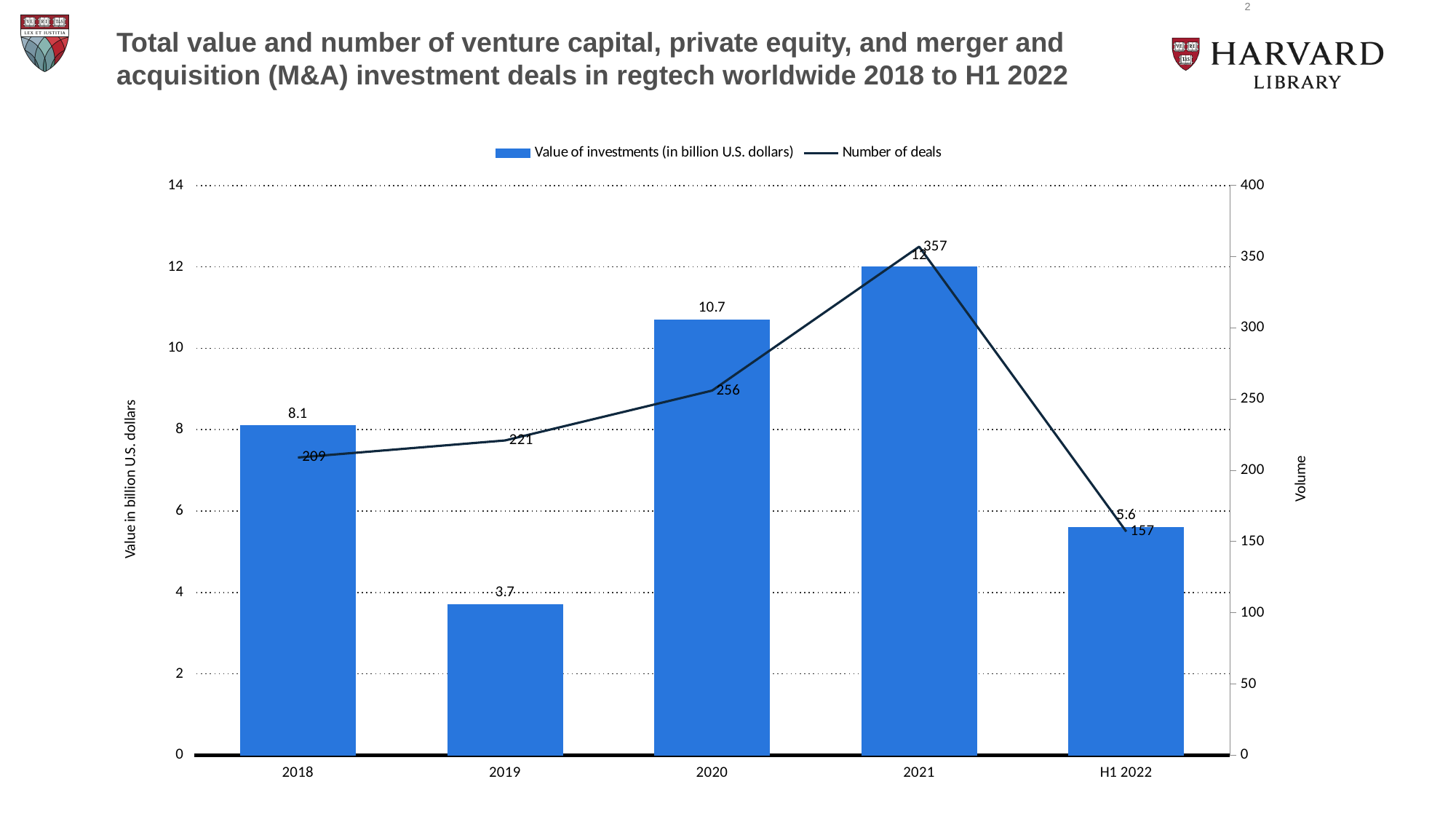
Which has a higher value of investments, 2018 or H1 2022? 2018 What is the value of investments for H1 2022? 5.6 Which period has the lowest number of deals? H1 2022 Did the number of deals rise or fall from 2018 to 2021? rise How many deals were recorded in 2021? 357 Which year has the lowest value of investments? 2019 What is the difference in the number of deals between 2021 and 2020? 101 What is the value of investments (in billion U.S. dollars) for 2020? 10.7 What is the difference in value of investments between 2018 and 2019? 4.4 Which year has the highest value of investments? 2021 How many periods are shown on the x axis? 5 How many series does the legend list? 2